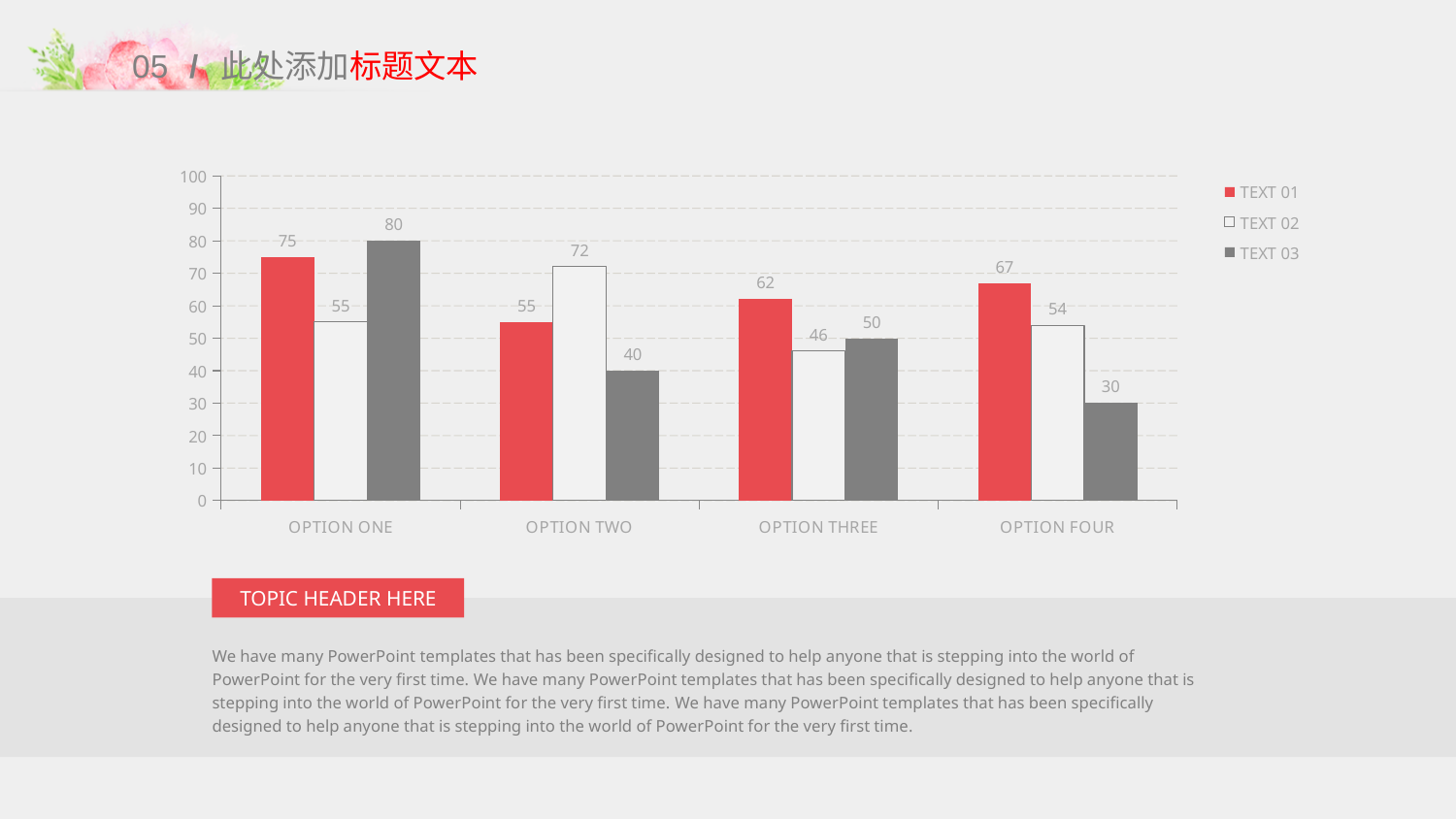
How many series does the legend list? 3 What is the difference between the TEXT 02 and TEXT 03 values for OPTION TWO? 32 What is the value of TEXT 03 for OPTION TWO? 40 How many categories are shown on the x axis? 4 Which category has the highest TEXT 03 value? OPTION ONE What is the value of TEXT 02 for OPTION THREE? 46 Which is larger for OPTION FOUR, TEXT 01 or TEXT 02? TEXT 01 What is the value of TEXT 01 for OPTION ONE? 75 What kind of chart is shown on the slide? bar chart Which category has the lowest TEXT 03 value? OPTION FOUR Is the TEXT 01 value for OPTION THREE greater or less than 50? greater What colour are the TEXT 01 bars? red